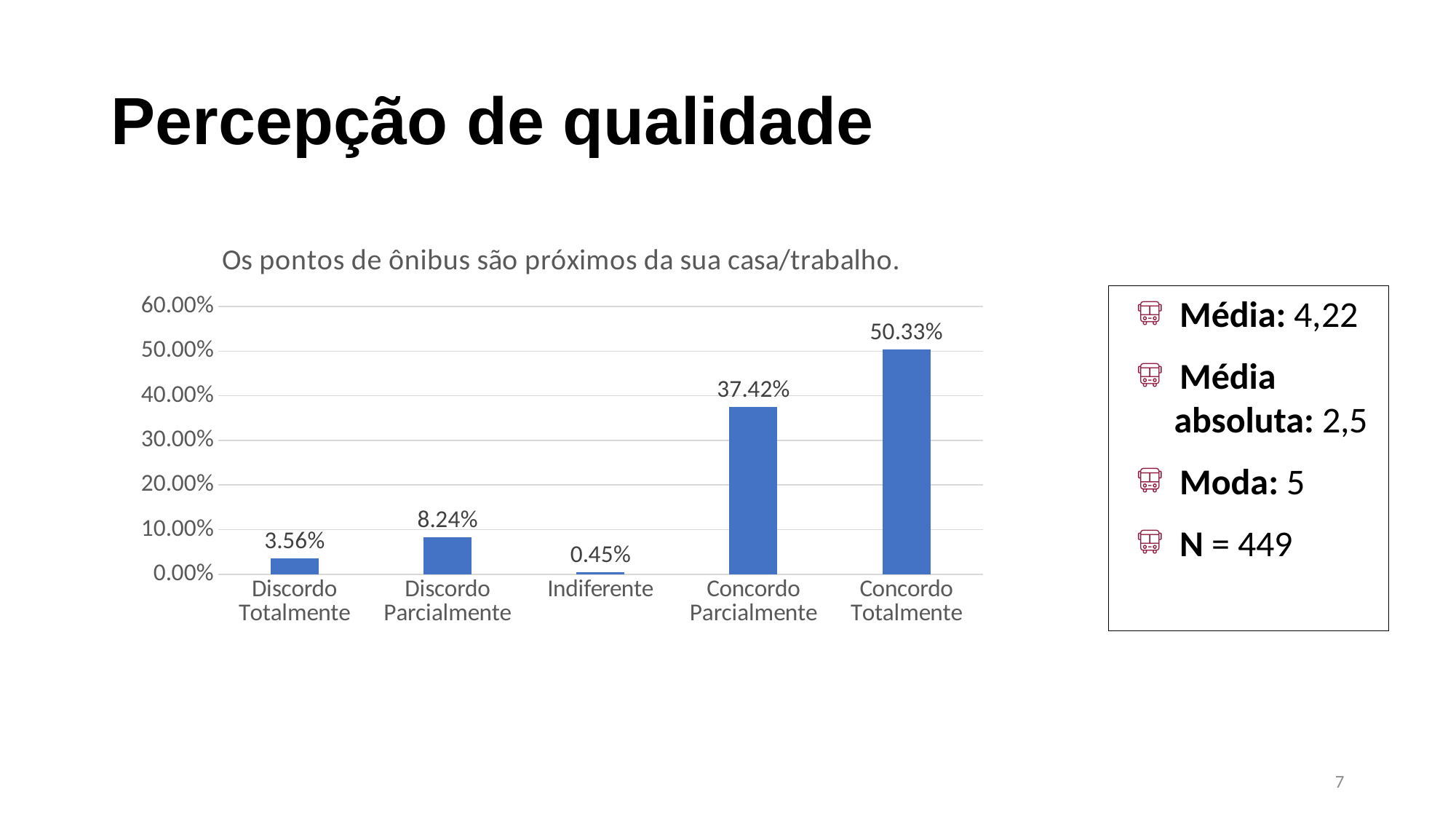
What is the difference between Discordo Parcialmente and Discordo Totalmente? 4.68% What kind of chart is shown? bar chart What is the value for Discordo Parcialmente? 8.24% Which category has the lowest value? Indiferente Which category has the highest value? Concordo Totalmente Which is larger, Discordo Totalmente or Discordo Parcialmente? Discordo Parcialmente What is the value for Concordo Totalmente? 50.33% What is the title of the chart? Os pontos de ônibus são próximos da sua casa/trabalho. How many categories are shown on the x axis? 5 What is the difference between Concordo Totalmente and Concordo Parcialmente? 12.91% What is the value for Indiferente? 0.45% Is the value for Concordo Parcialmente greater or less than 30.00%? greater